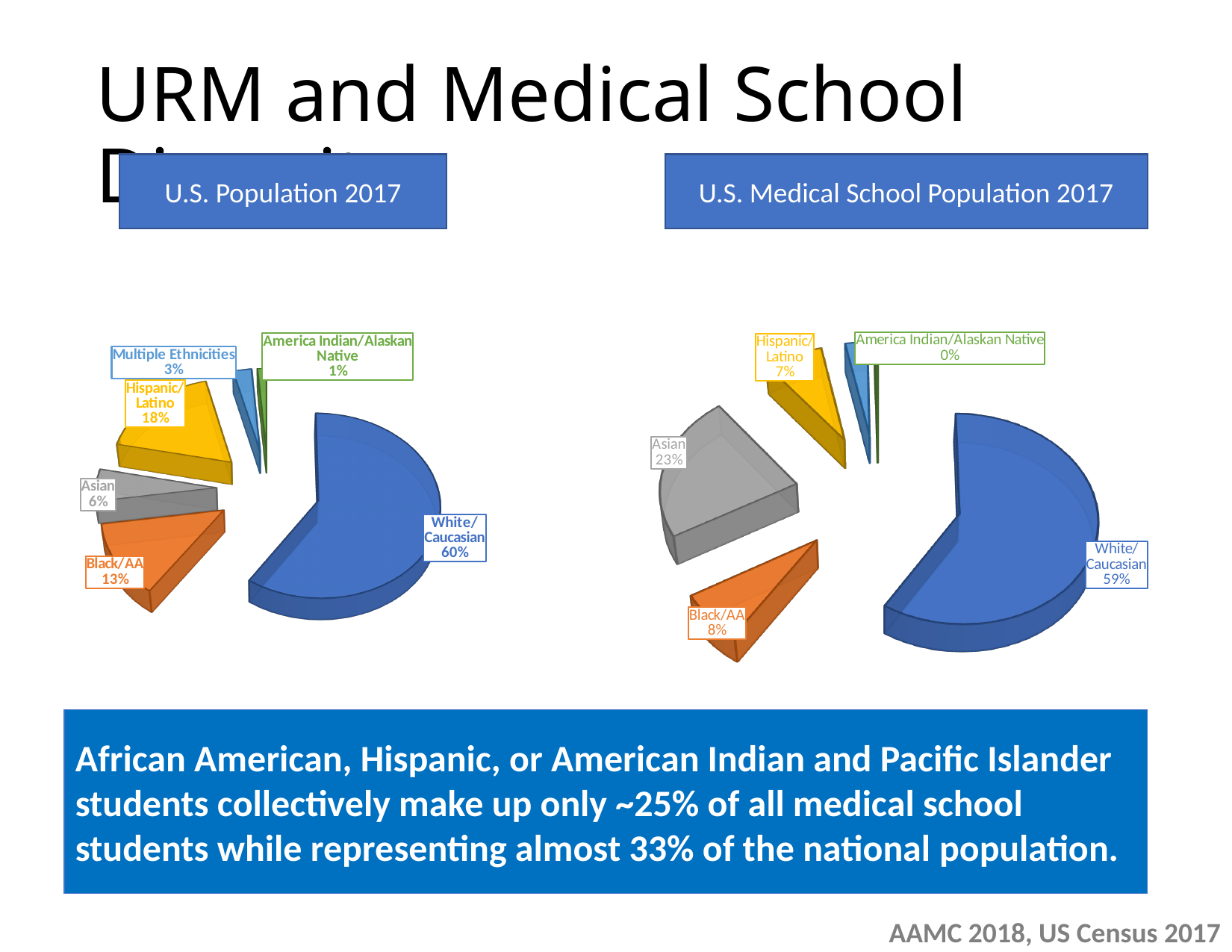
What is the difference between the Black/AA share in the U.S. Population 2017 chart and in the U.S. Medical School Population 2017 chart? 5% In the U.S. Medical School Population 2017 chart, what share is Black/AA? 8% Which is larger: the Asian share in the U.S. Population 2017 chart or in the U.S. Medical School Population 2017 chart? U.S. Medical School Population 2017 In the U.S. Population 2017 chart, which group has the largest share? White/Caucasian How many labeled slices does the U.S. Population 2017 chart have? 6 In the U.S. Population 2017 chart, what share is White/Caucasian? 60% In the U.S. Population 2017 chart, what share is Hispanic/Latino? 18% In the U.S. Medical School Population 2017 chart, which labeled group has the smallest share? America Indian/Alaskan Native What is the title of the chart on the right side of the slide? U.S. Medical School Population 2017 In the U.S. Medical School Population 2017 chart, what share is Asian? 23% What type of chart is used for the U.S. Population 2017 data? Pie chart In the U.S. Population 2017 chart, which group has the smallest share? America Indian/Alaskan Native